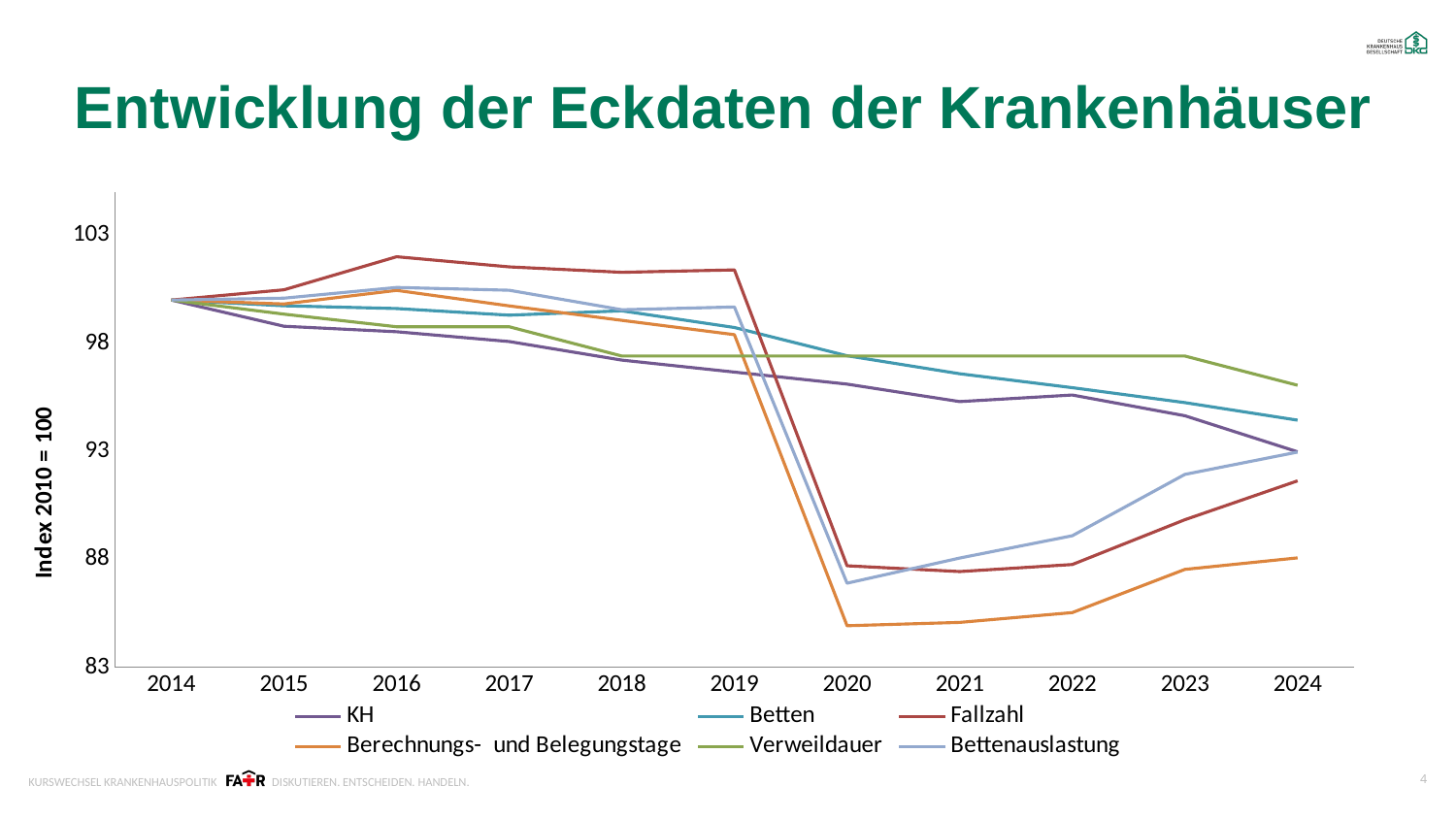
In 2024, which is higher: Verweildauer or Berechnungs- und Belegungstage? Verweildauer What kind of chart is shown on the slide? line chart Is the value for Berechnungs- und Belegungstage in 2020 greater or less than 88? less Is the value for Betten in 2024 greater or less than 93? greater Does the Berechnungs- und Belegungstage line rise or fall from 2019 to 2020? fall What is the label on the y axis? Index 2010 = 100 How many years are shown along the x axis? 11 What is the title of the slide's chart? Entwicklung der Eckdaten der Krankenhäuser How many series does the legend list? 6 Which series has the lowest value in 2024? Berechnungs- und Belegungstage Is the value for Fallzahl in 2016 greater or less than 98? greater Which series has the highest value in 2016? Fallzahl